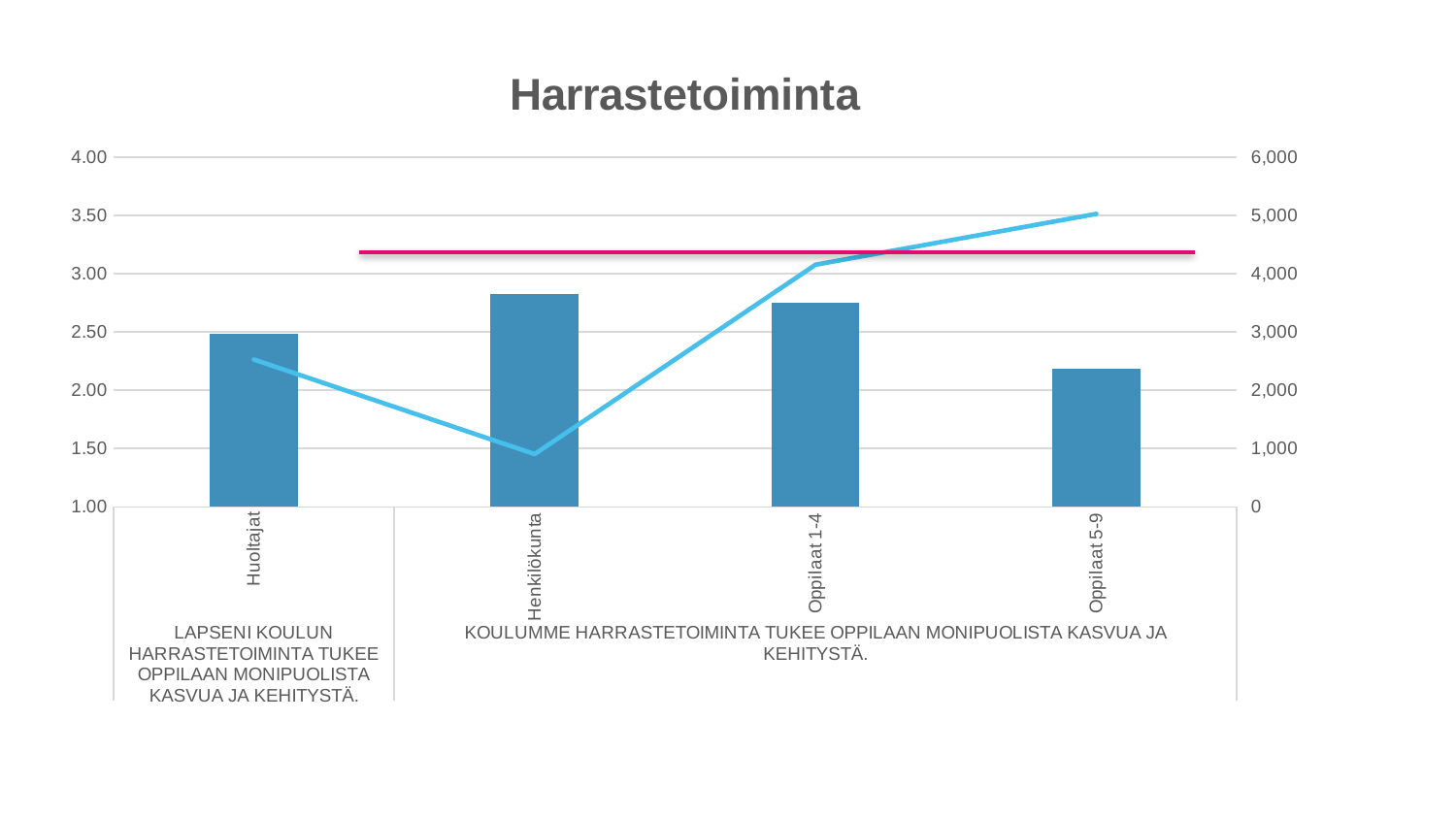
Which category has the lowest bar in the chart? Oppilaat 5-9 Which bar is taller, Huoltajat or Oppilaat 5-9? Huoltajat Is the blue line value for Oppilaat 5-9 greater or less than 4,000 on the right axis? greater What kind of chart is shown on the slide? A combined bar and line chart Is the bar value for Huoltajat greater or less than 2.00? greater What is the title of the chart? Harrastetoiminta Does the blue line rise or fall from Henkilökunta to Oppilaat 5-9? rises At which category does the blue line reach its highest point? Oppilaat 5-9 How many categories are shown on the x axis of the chart? 4 At which category does the blue line reach its lowest point? Henkilökunta Is the bar value for Henkilökunta greater or less than 2.50? greater